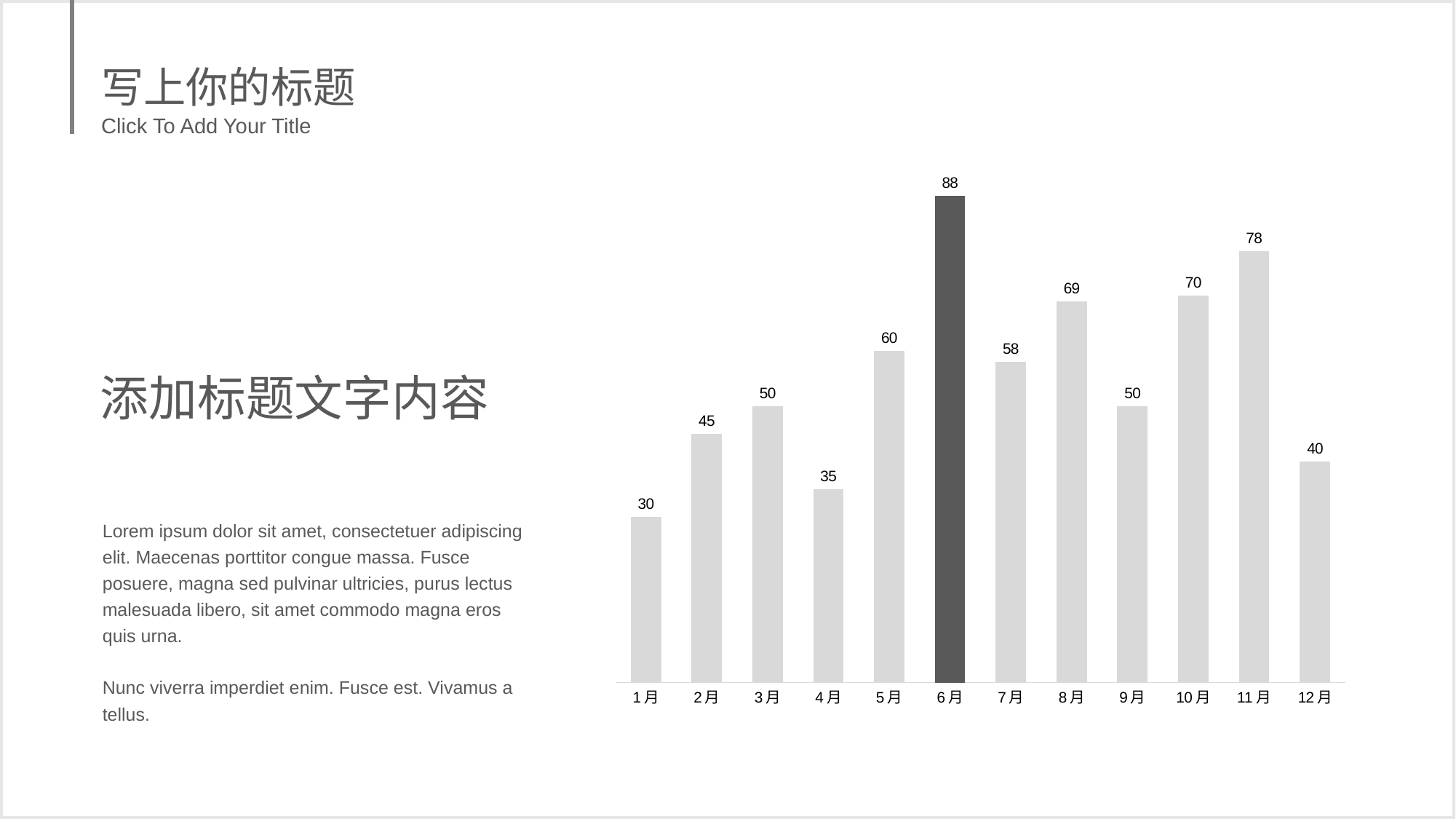
Do the values rise or fall from 1月 to 3月? rise Which is larger, the value for 5月 or the value for 7月? 5月 Which month has the highest value? 6月 Which bar is shaded darker than the others? 6月 Which month has the lowest value? 1月 What is the value for 11月? 78 What is the value for 6月? 88 How many months are shown on the x axis? 12 What is the difference between the values for 6月 and 12月? 48 What is the difference between the values for 10月 and 8月? 1 What is the value for 4月? 35 What kind of chart is shown on the slide? bar chart